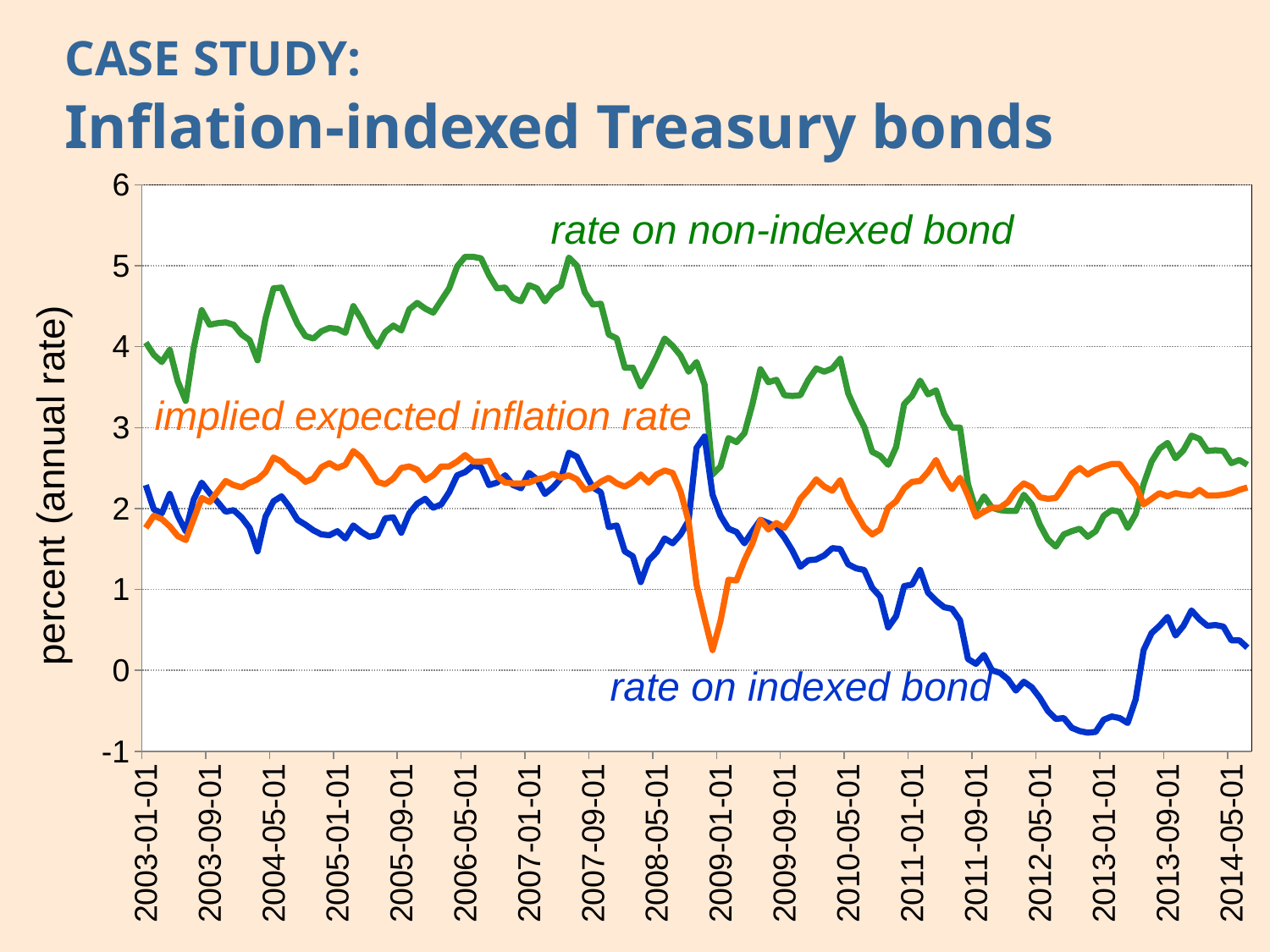
At 2013-01-01, which is higher: the implied expected inflation rate or the rate on indexed bond? implied expected inflation rate Is the rate on indexed bond at 2003-01-01 greater or less than 3? less At 2003-01-01, which is higher: the rate on non-indexed bond or the rate on indexed bond? rate on non-indexed bond Is the rate on non-indexed bond at 2003-01-01 greater or less than 3? greater Is the implied expected inflation rate at 2009-01-01 greater or less than 1? less Overall, does the rate on indexed bond rise or fall from 2003-01-01 to 2014-05-01? fall What is the label on the vertical axis? percent (annual rate) What colour is the line for the rate on indexed bond? blue How many series are plotted on the chart? 3 What kind of chart is shown on the slide? line chart